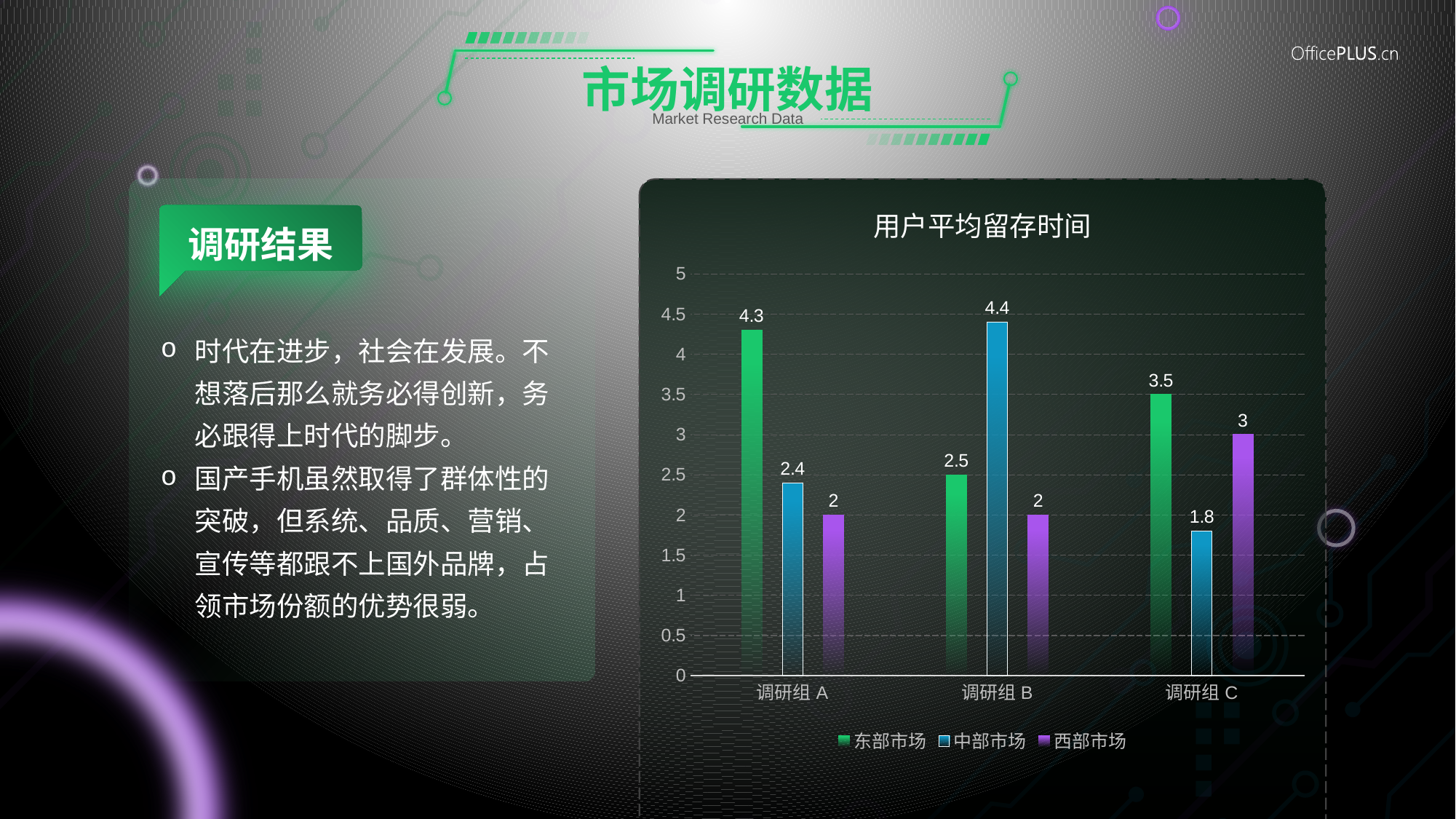
What kind of chart is shown? Bar chart What is the value for 中部市场 in 调研组 C? 1.8 What is the title of the chart? 用户平均留存时间 Which group has the lowest value for 中部市场? 调研组 C What is the value for 东部市场 in 调研组 A? 4.3 What is the value for 西部市场 in 调研组 C? 3 What is the difference between 东部市场 and 西部市场 in 调研组 A? 2.3 How many groups are shown on the x axis? 3 What is the value for 中部市场 in 调研组 B? 4.4 Which is larger in 调研组 B: 东部市场 or 中部市场? 中部市场 How many series does the legend list? 3 Which group has the highest value for 东部市场? 调研组 A